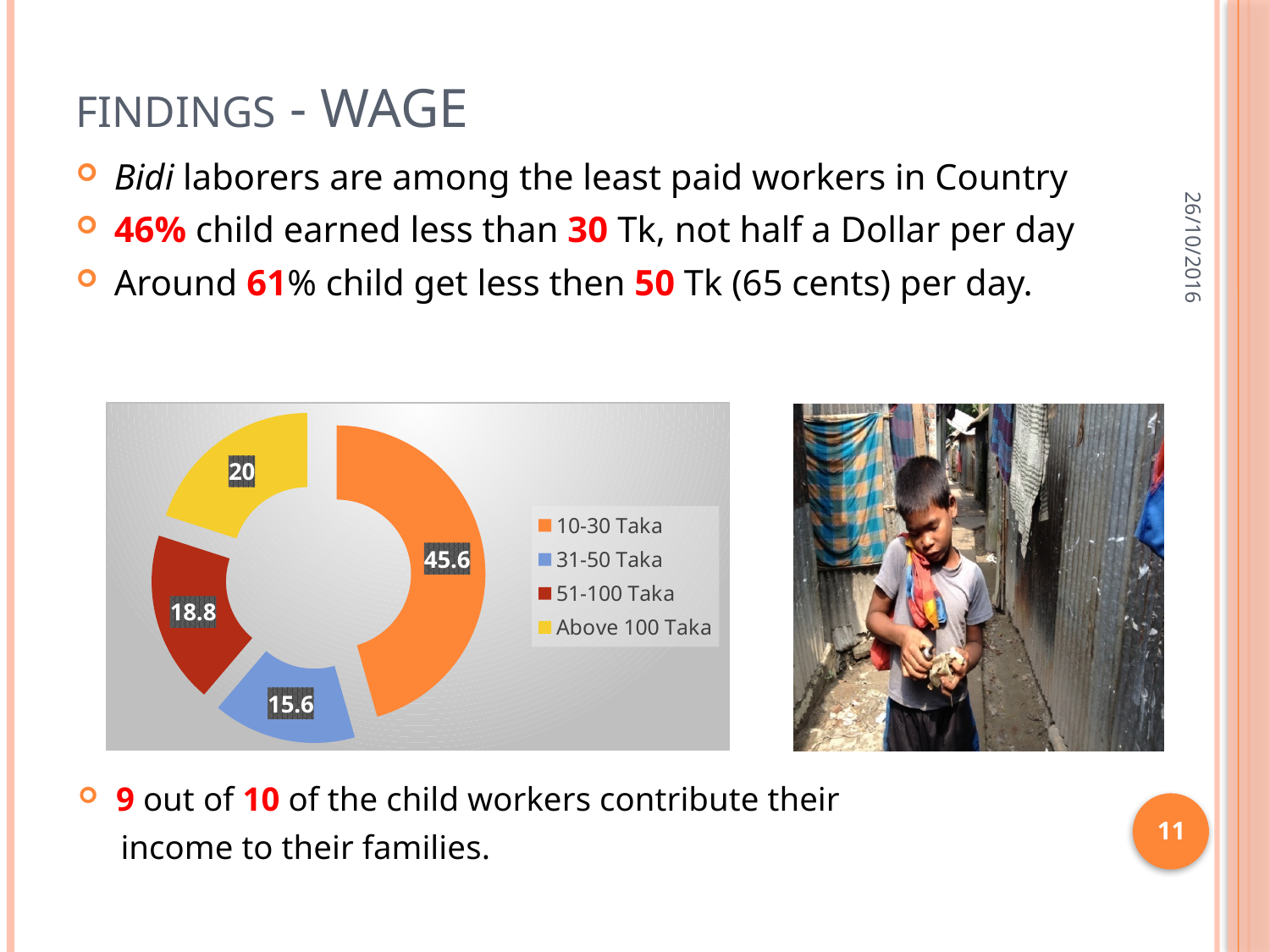
What colour represents the 51-100 Taka category in the doughnut chart? dark red How many wage categories are shown in the doughnut chart? 4 What is the difference between the 10-30 Taka value and the Above 100 Taka value in the doughnut chart? 25.6 Which wage category has the smallest segment in the doughnut chart? 31-50 Taka What is the difference between the 51-100 Taka value and the 31-50 Taka value in the doughnut chart? 3.2 Which is larger in the doughnut chart, the Above 100 Taka segment or the 51-100 Taka segment? Above 100 Taka What value is shown for the 51-100 Taka segment of the doughnut chart? 18.8 What value is shown for the Above 100 Taka segment of the doughnut chart? 20 What kind of chart is used to show the wage distribution on the slide? doughnut chart What value is shown for the 10-30 Taka segment of the doughnut chart? 45.6 What value is shown for the 31-50 Taka segment of the doughnut chart? 15.6 Which wage category has the largest segment in the doughnut chart? 10-30 Taka